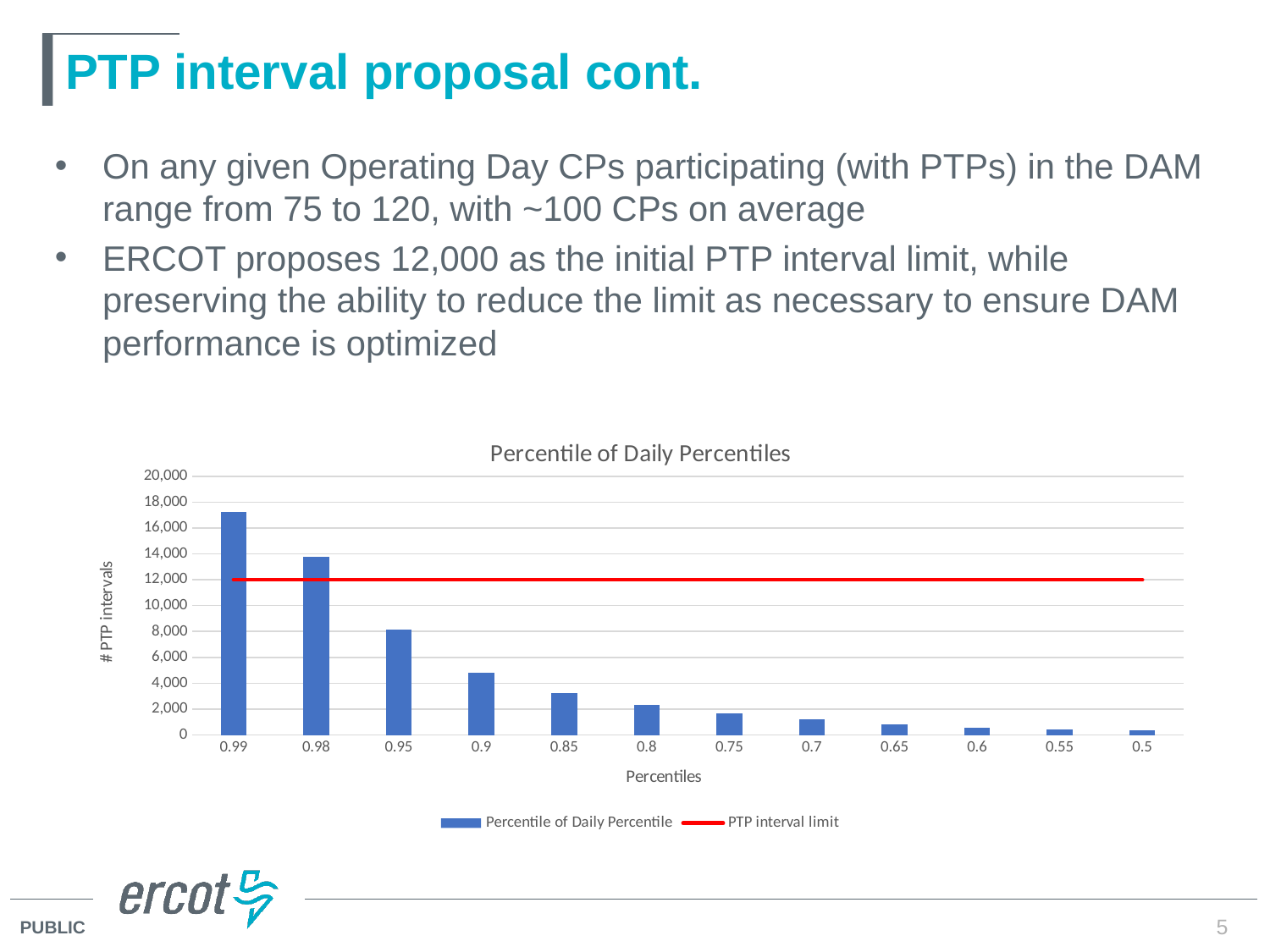
Is the value for the 0.9 percentile greater or less than 4,000? greater How many percentile categories are shown on the x axis of the chart? 12 At what value on the y axis is the PTP interval limit line drawn? 12,000 Which percentile has the lowest number of PTP intervals? 0.5 What is the title of the chart? Percentile of Daily Percentiles Is the value for the 0.95 percentile greater or less than 10,000? less Which has more PTP intervals, the 0.98 percentile or the 0.85 percentile? 0.98 How many series does the chart legend list? 2 Which percentile has the highest number of PTP intervals? 0.99 Do the bar values rise or fall moving from left to right along the x axis? fall Is the value for the 0.99 percentile greater or less than 16,000? greater What kind of chart is shown on the slide? bar and line chart